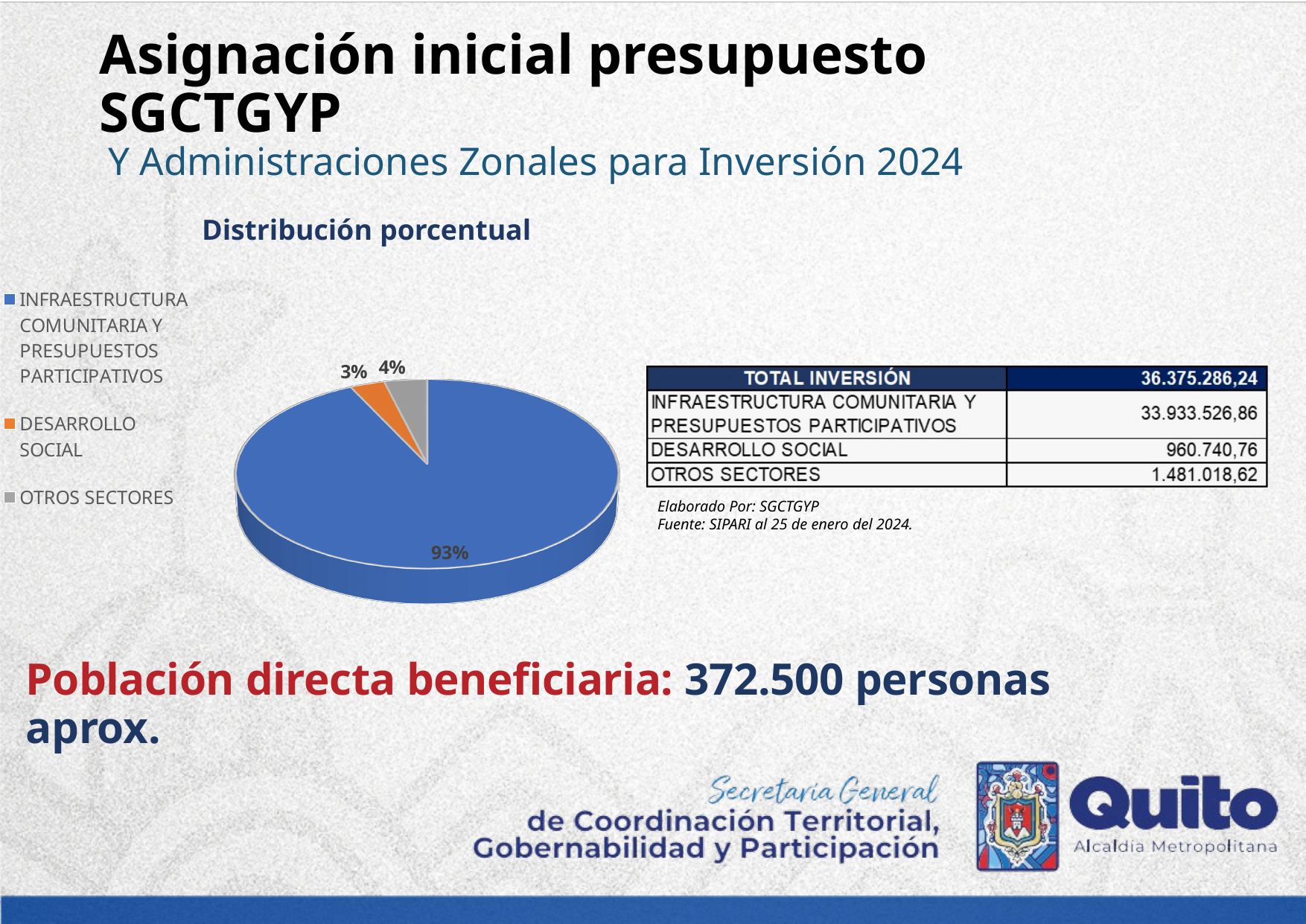
What colour is the slice for DESARROLLO SOCIAL in the pie chart? orange What share of the pie does INFRAESTRUCTURA COMUNITARIA Y PRESUPUESTOS PARTICIPATIVOS represent? 93% What is the difference in percentage points between the OTROS SECTORES slice and the DESARROLLO SOCIAL slice? 1% What is the title shown above the pie chart? Distribución porcentual What kind of chart is shown under the heading "Distribución porcentual"? pie chart How many slices does the pie chart have? 3 Which slice is larger, OTROS SECTORES or DESARROLLO SOCIAL? OTROS SECTORES What share of the pie does OTROS SECTORES represent? 4% Which category has the smallest slice of the pie? DESARROLLO SOCIAL Which category has the largest slice of the pie? INFRAESTRUCTURA COMUNITARIA Y PRESUPUESTOS PARTICIPATIVOS What share of the pie does DESARROLLO SOCIAL represent? 3% How many entries does the legend of the pie chart list? 3